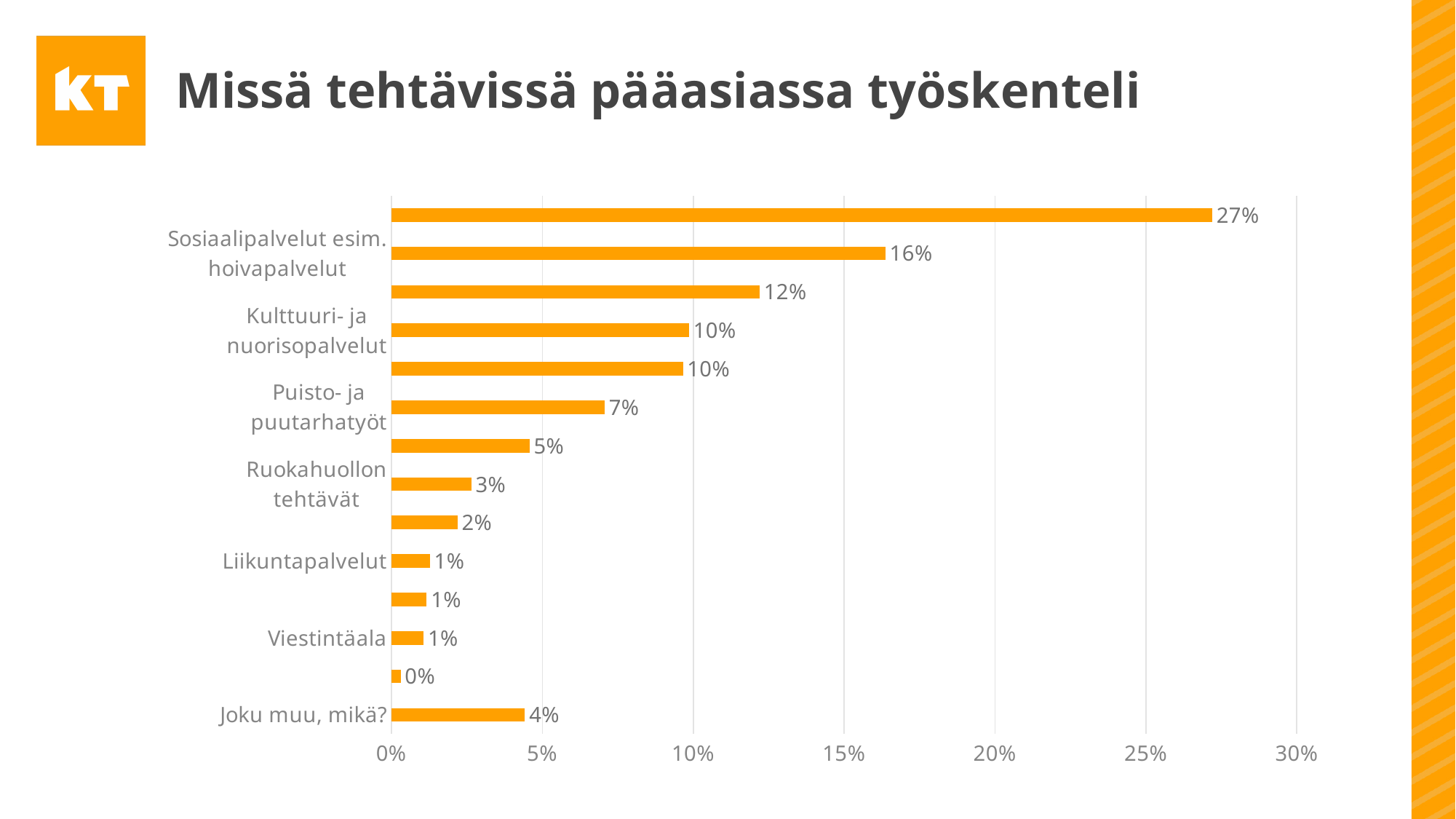
What kind of chart is shown on the slide? bar chart What is the value for Kulttuuri- ja nuorisopalvelut? 10% What is the value for Joku muu, mikä? 4% What is the value for Puisto- ja puutarhatyöt? 7% Which is larger, the value for Puisto- ja puutarhatyöt or the value for Joku muu, mikä? Puisto- ja puutarhatyöt What is the value for Sosiaalipalvelut esim. hoivapalvelut? 16% What is the value for Ruokahuollon tehtävät? 3% What is the lowest value shown on the chart? 0% What is the title of the chart on the slide? Missä tehtävissä pääasiassa työskenteli What is the highest value shown on the chart? 27% How many bars are plotted on the chart? 14 What is the difference between the values for Sosiaalipalvelut esim. hoivapalvelut and Kulttuuri- ja nuorisopalvelut? 6%